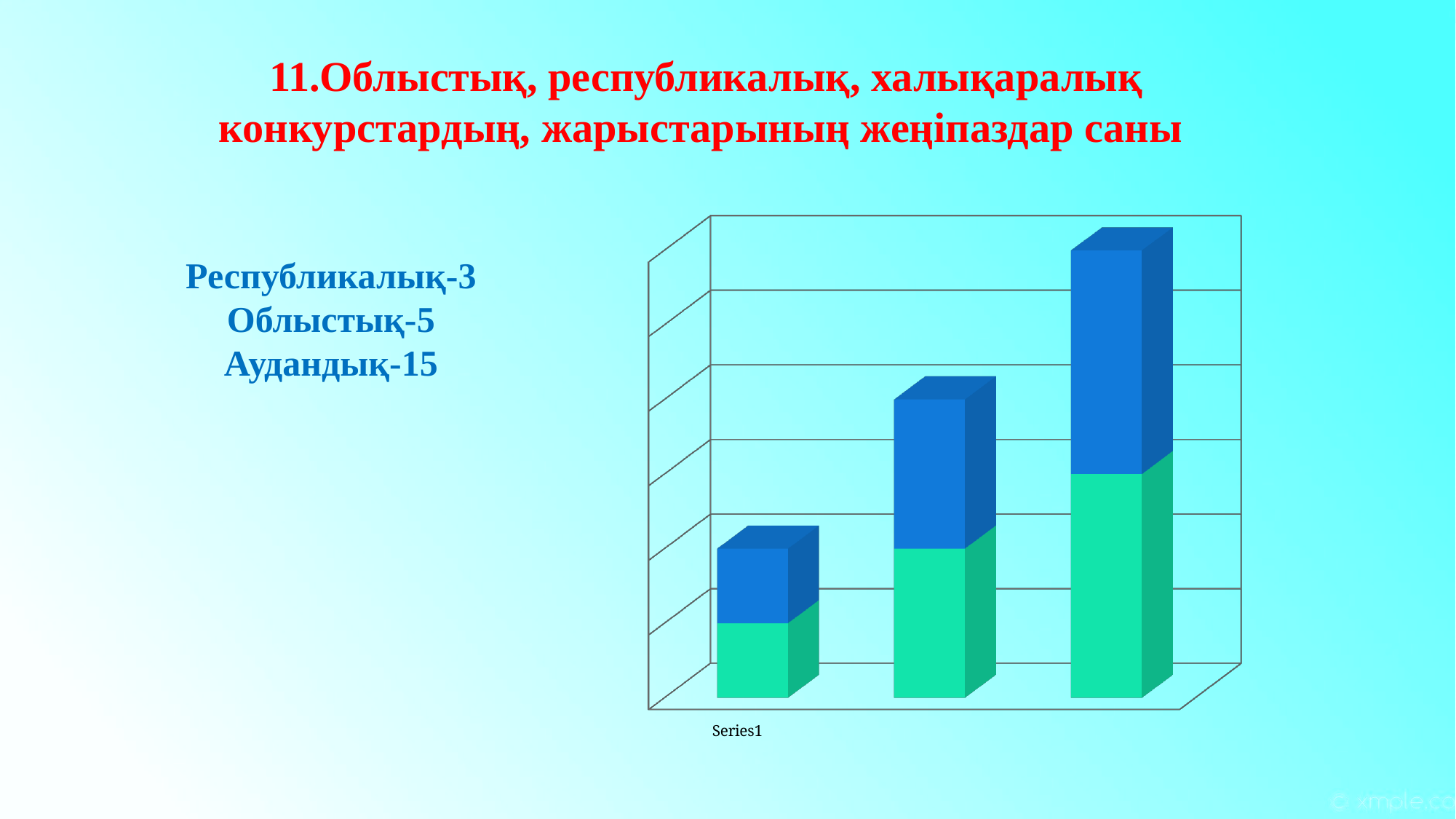
How many colour segments does each stacked bar have? 2 How many bars are plotted in the chart? 3 Which is taller, the leftmost bar or the middle bar? middle bar Which bar is the tallest in the chart: the leftmost, middle, or rightmost? rightmost What label is printed below the horizontal axis of the chart? Series1 Which is taller, the middle bar or the rightmost bar? rightmost bar Do the bar heights rise or fall from left to right across the chart? rise What kind of chart is shown on the slide? bar chart Which bar is the shortest in the chart: the leftmost, middle, or rightmost? leftmost